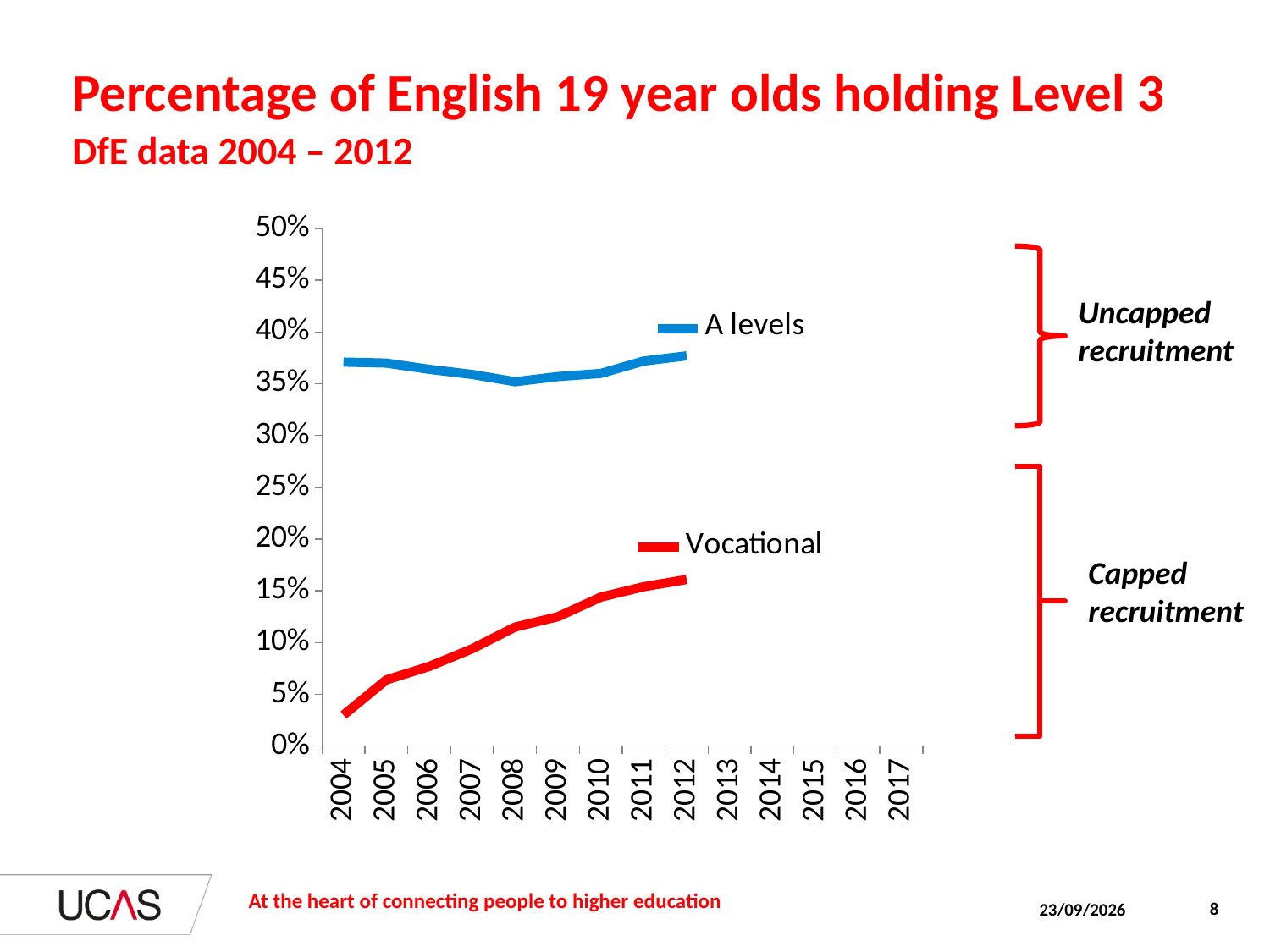
What kind of chart is shown on the slide? Line chart What are the two series named in the chart's legend? A levels and Vocational In which year is the A levels value lowest? 2008 In which year is the Vocational value lowest? 2004 How many series does the chart's legend list? 2 Is the value for Vocational in 2012 greater or less than 15%? greater Is the value for A levels in 2012 greater or less than 35%? greater In which year is the Vocational value highest? 2012 Is the value for Vocational in 2004 greater or less than 5%? less Which series has the higher value in 2012, A levels or Vocational? A levels Does the Vocational line rise or fall from 2004 to 2012? Rises Which series is labelled with the annotation 'Capped recruitment'? Vocational